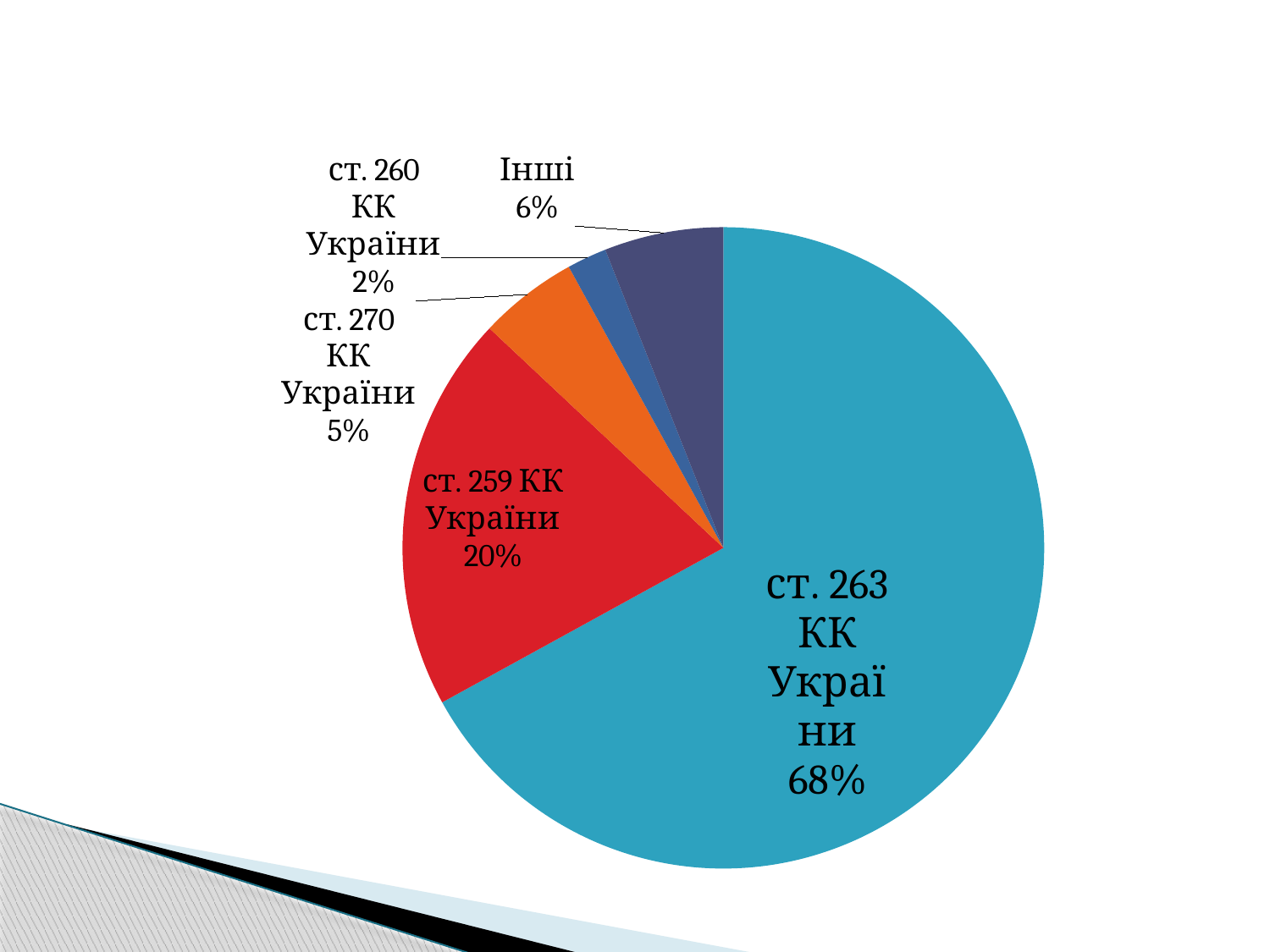
What share of the pie does ст. 259 КК України have? 20% Which slice of the pie is the smallest? ст. 260 КК України What kind of chart is shown on the slide? pie chart What share of the pie does ст. 270 КК України have? 5% What colour is the slice for ст. 259 КК України? red Which slice of the pie is the largest? ст. 263 КК України What share of the pie does the Інші slice have? 6% What is the difference in percentage points between ст. 263 КК України and ст. 259 КК України? 48 How many slices does the pie chart have? 5 Which is larger, the share for Інші or the share for ст. 270 КК України? Інші